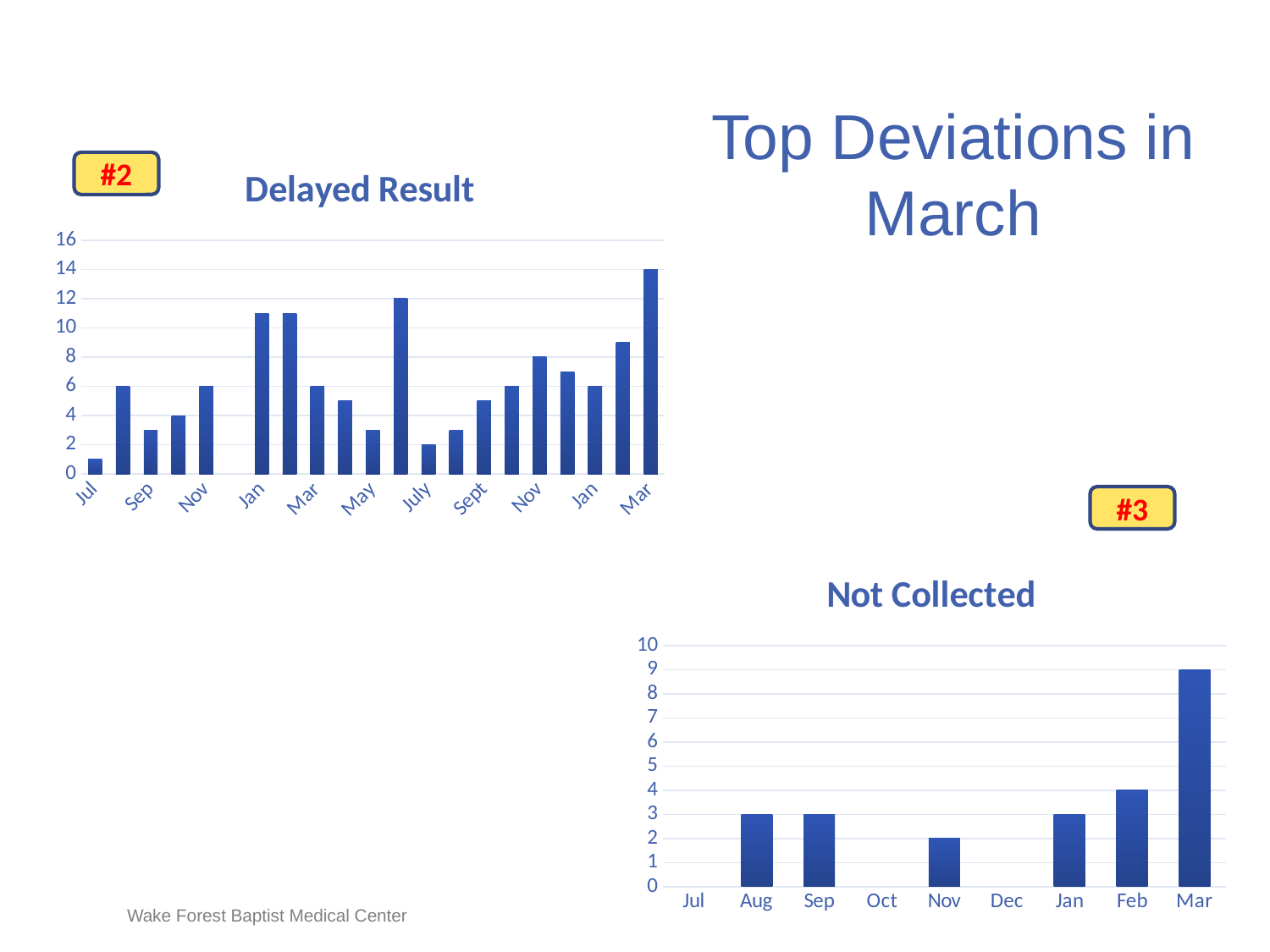
In the Delayed Result chart, is the value for the first Jan greater or less than 10? greater In the Not Collected chart, how many months are shown on the x axis? 9 In the Not Collected chart, which is larger, the value for Feb or the value for Nov? Feb In the Delayed Result chart, what is the value for the last Mar bar on the right? 14 In the Not Collected chart, what is the difference between the values for Mar and Feb? 5 In the Delayed Result chart, which month has the highest value? Mar (the last bar) In the Not Collected chart, which month has the highest value? Mar In the Not Collected chart, what is the value for Nov? 2 In the Not Collected chart, what is the value for Mar? 9 In the Not Collected chart, what is the value for Feb? 4 What kind of chart is the Delayed Result chart? bar chart What is the title of the chart in the bottom right of the slide? Not Collected